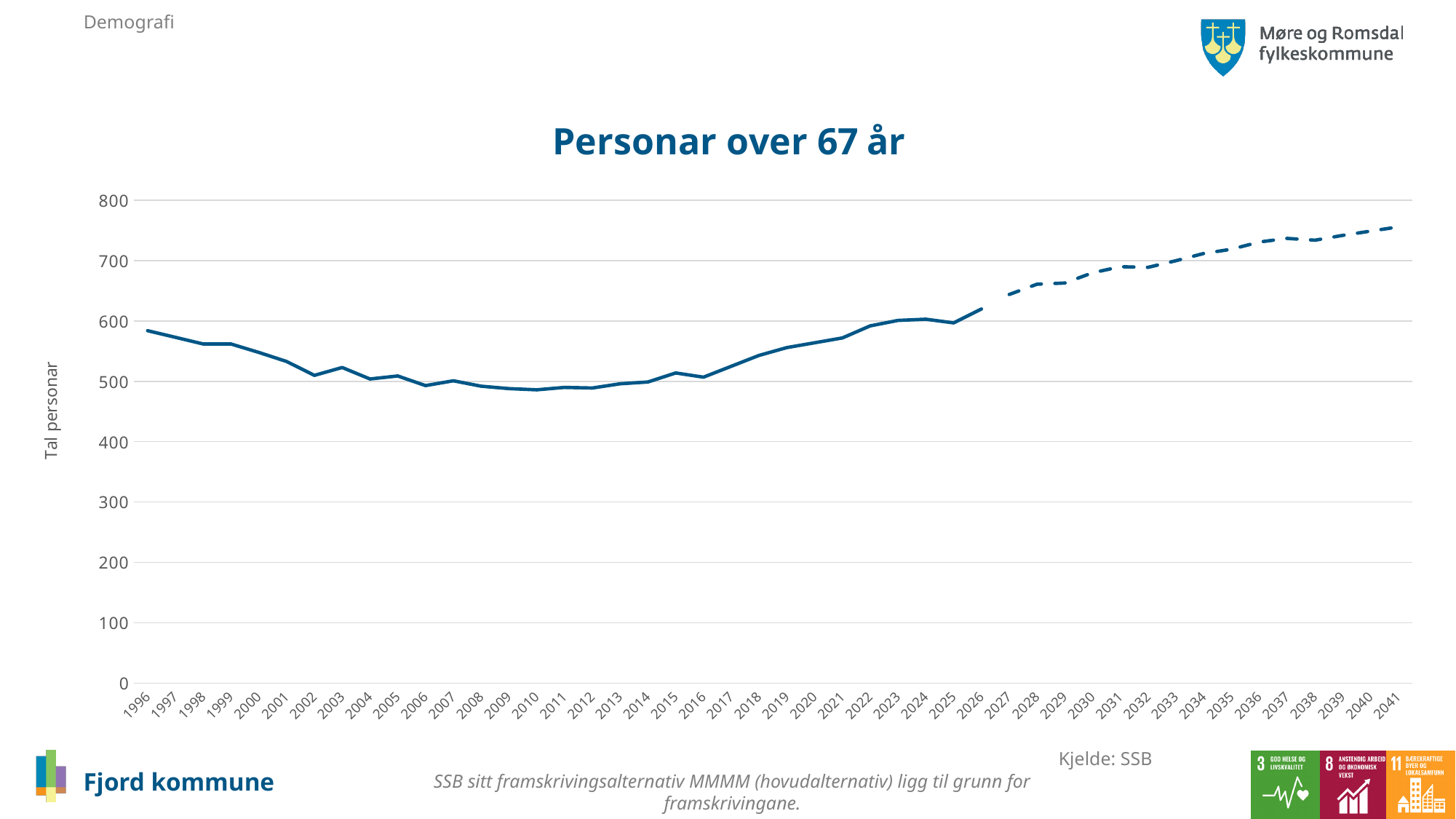
Is the value for 2041 greater or less than 700? greater What is the title of the chart? Personar over 67 år What is the label on the vertical axis of the chart? Tal personar Do the values rise or fall from 2016 to 2041? rise Is the value for 2026 greater or less than 600? greater How many years are shown along the x axis of the chart? 46 Which is larger, the value for 1996 or the value for 2026? 2026 Is the value for 2029 greater or less than 700? less What kind of chart is shown on the slide? line chart Which year has the highest value in the chart? 2041